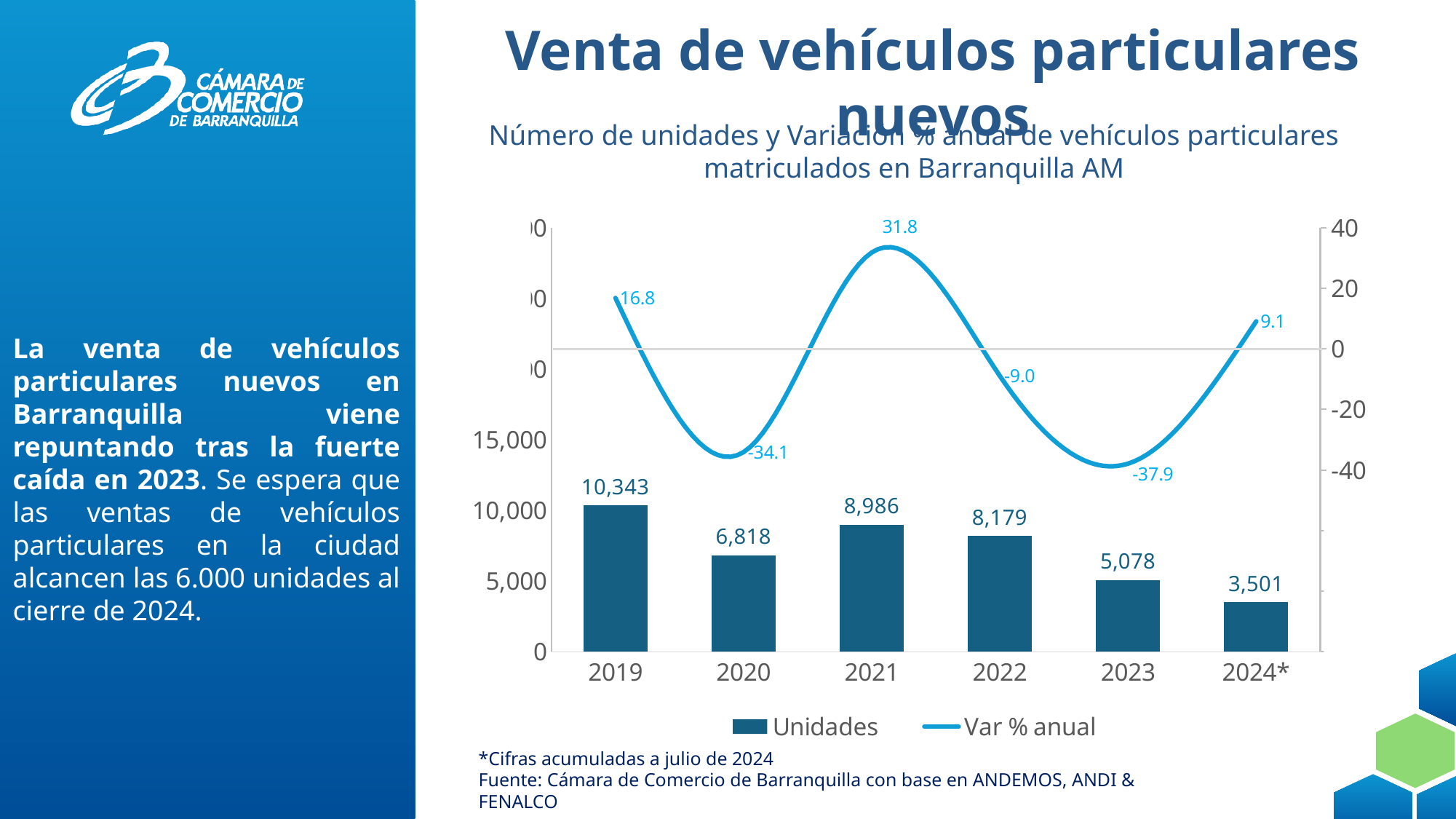
Which year has more Unidades, 2021 or 2022? 2021 What is the value of Unidades for 2021? 8,986 What is the highest Var % anual value shown on the chart? 31.8 What is the Var % anual value for 2023? -37.9 Which year has the lowest Var % anual value? 2023 What is the difference in Unidades between 2019 and 2020? 3,525 Do the Unidades values rise or fall from 2021 to 2024*? Fall Which year has the highest value of Unidades? 2019 How many years are shown on the x axis? 6 What kind of chart is used to show the Unidades series? Bar chart How many series does the legend list? 2 What is the value of Unidades for 2024*? 3,501